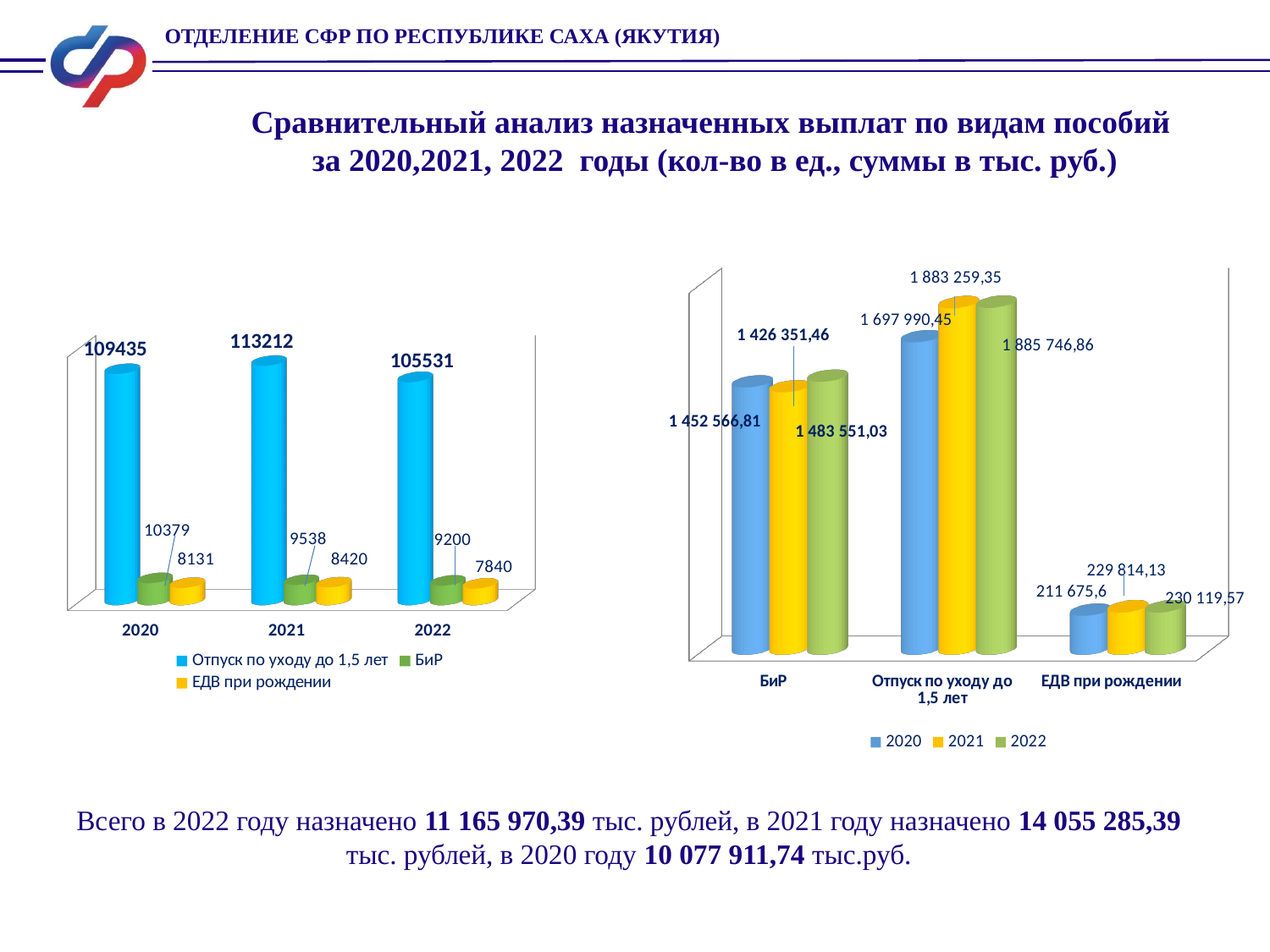
In the left chart, what is the value for БиР in 2020? 10379 What kind of chart is the right chart? bar chart In the left chart, which year has the lowest value for ЕДВ при рождении? 2022 In the right chart, what is the value for ЕДВ при рождении in 2020? 211 675,6 In the left chart, how many series does the legend list? 3 In the right chart, which category has the lowest values across all years? ЕДВ при рождении In the right chart, is the 2021 value for БиР larger or smaller than the 2022 value for БиР? smaller In the right chart, what is the value for Отпуск по уходу до 1,5 лет in 2022? 1 885 746,86 In the left chart, what is the value for ЕДВ при рождении in 2022? 7840 In the left chart, which year has the highest value for Отпуск по уходу до 1,5 лет? 2021 In the left chart, what is the difference between the Отпуск по уходу до 1,5 лет values for 2021 and 2022? 7681 In the left chart, what is the value for Отпуск по уходу до 1,5 лет in 2021? 113212